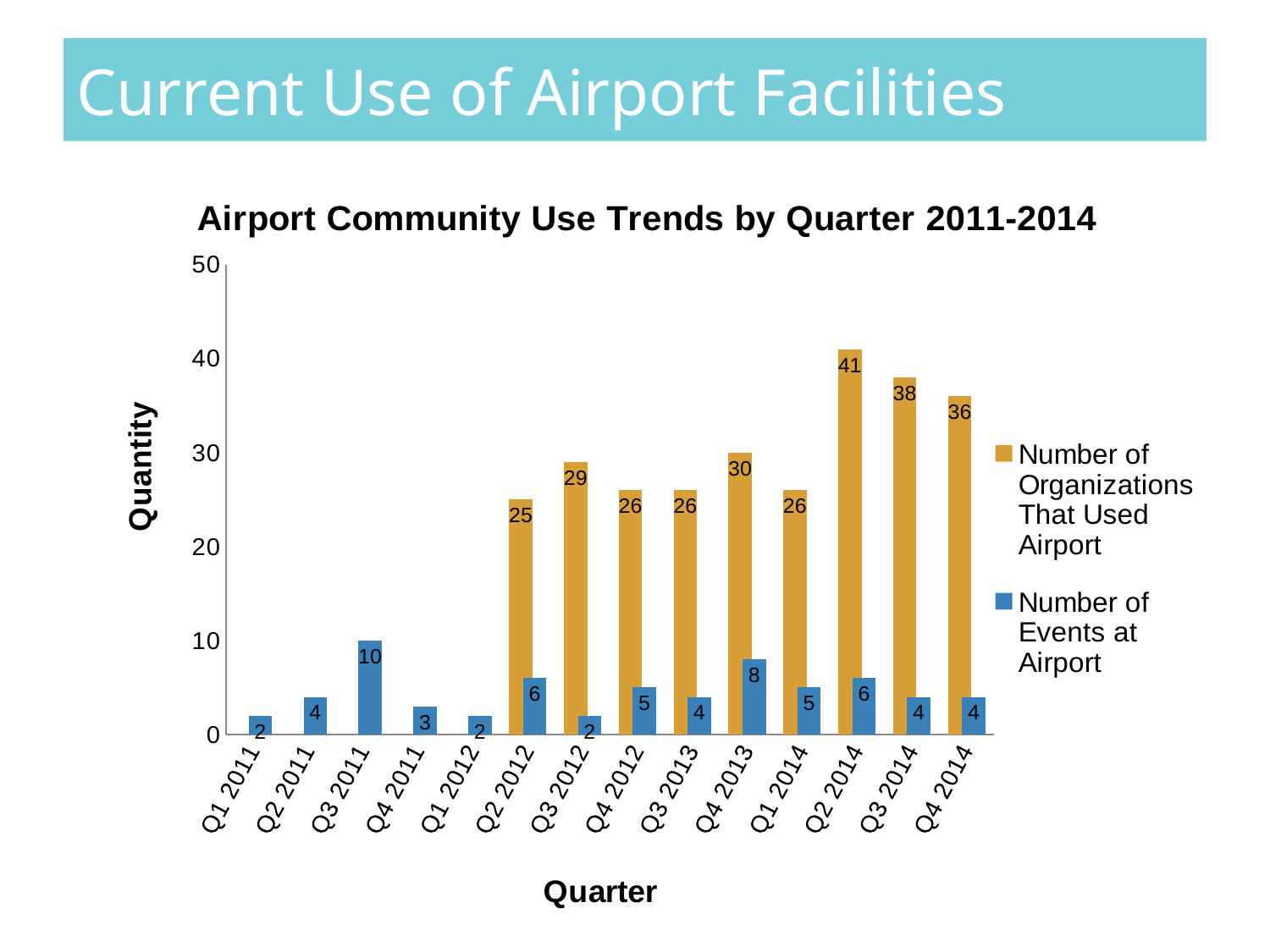
What is the difference between the Number of Organizations That Used Airport in Q2 2014 and Q4 2014? 5 In which quarter is the Number of Events at Airport highest? Q3 2011 What is the Number of Organizations That Used Airport in Q2 2014? 41 What is the Number of Events at Airport in Q3 2011? 10 What is the Number of Organizations That Used Airport in Q3 2012? 29 What is the title of the chart? Airport Community Use Trends by Quarter 2011-2014 What type of chart is shown on the slide? Bar chart How many series does the legend list? 2 How many quarters are shown on the x axis? 14 Is the Number of Organizations That Used Airport in Q3 2014 greater or less than 30? greater Which is larger: the Number of Events at Airport in Q4 2013 or in Q2 2012? Q4 2013 In which quarter is the Number of Organizations That Used Airport highest? Q2 2014